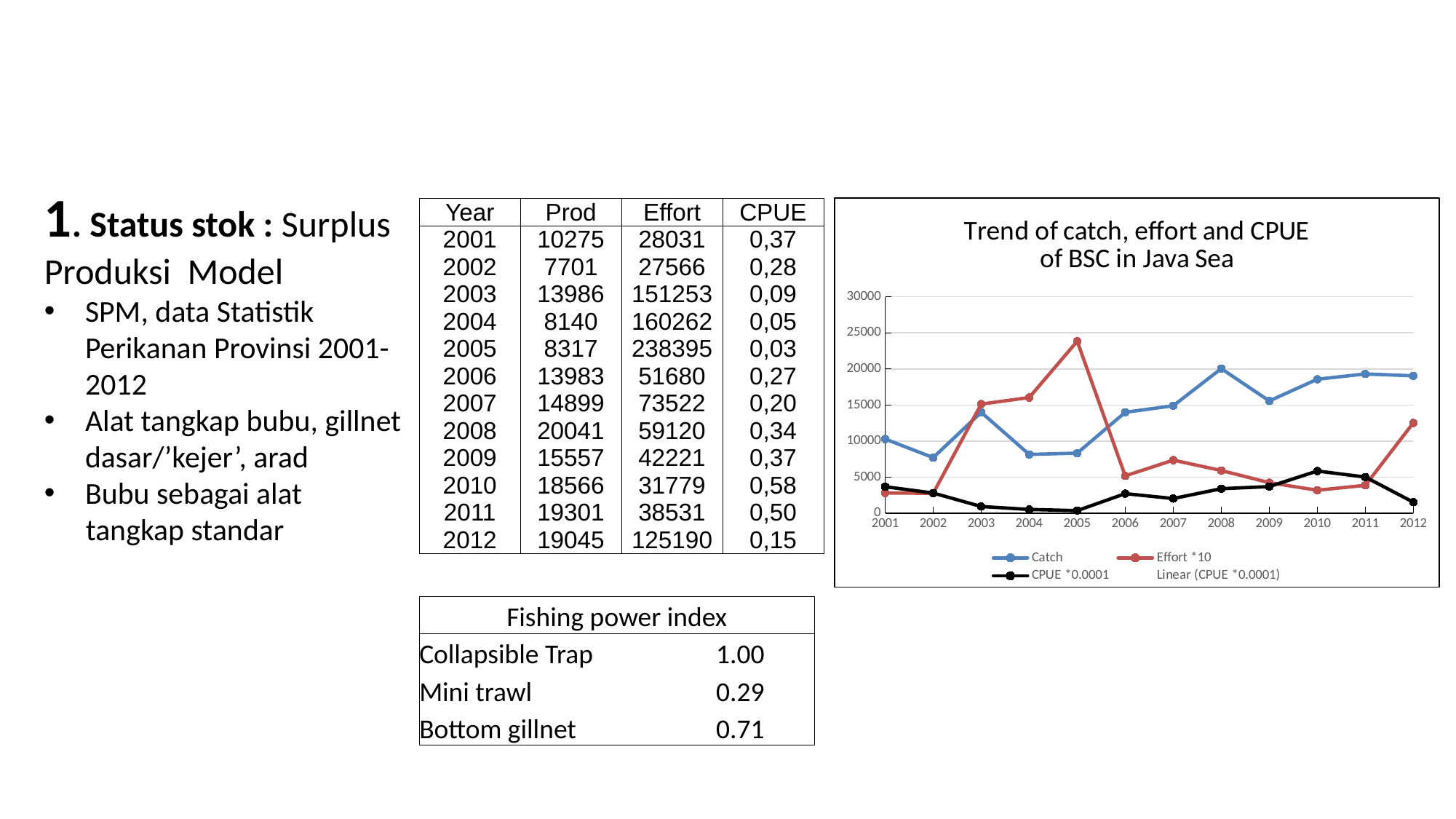
In which year does the Catch series reach its highest value? 2008 What kind of chart is shown on the slide? line chart How many entries does the chart legend list? 4 What is the title of the chart? Trend of catch, effort and CPUE of BSC in Java Sea What colour is the Catch line in the chart? blue Is the value of CPUE *0.0001 in 2010 greater or less than 5000? greater Does the Effort *10 series rise or fall from 2005 to 2006? fall How many years are plotted along the x axis of the chart? 12 Is the value of Catch in 2002 greater or less than 10000? less In 2008, which is larger: Catch or Effort *10? Catch Is the value of Effort *10 in 2005 greater or less than 20000? greater In which year does the Effort *10 series reach its highest value? 2005